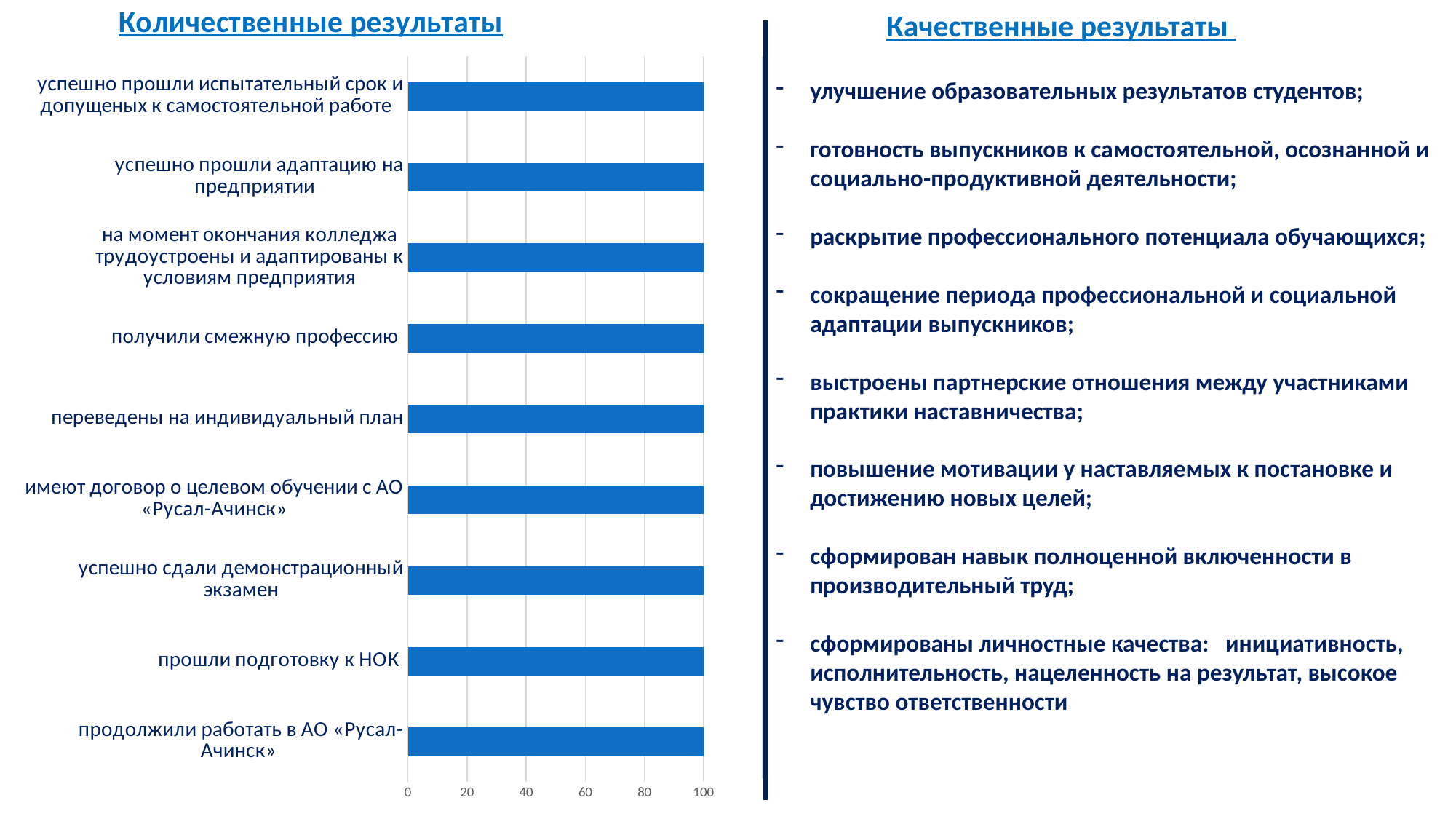
What is the title above the bar chart? Количественные результаты What is the value for «получили смежную профессию»? 100 What is the difference between the values for «прошли подготовку к НОК» and «получили смежную профессию»? 0 Is the value for «переведены на индивидуальный план» greater or less than 80? greater What is the value for «прошли подготовку к НОК»? 100 What kind of chart is shown under the heading «Количественные результаты»? bar chart How many categories does the bar chart show? 9 Is the value for «успешно прошли адаптацию на предприятии» greater or less than 60? greater What is the value for «продолжили работать в АО «Русал-Ачинск»»? 100 What is the value for «успешно сдали демонстрационный экзамен»? 100 What is the highest value shown on the horizontal axis of the bar chart? 100